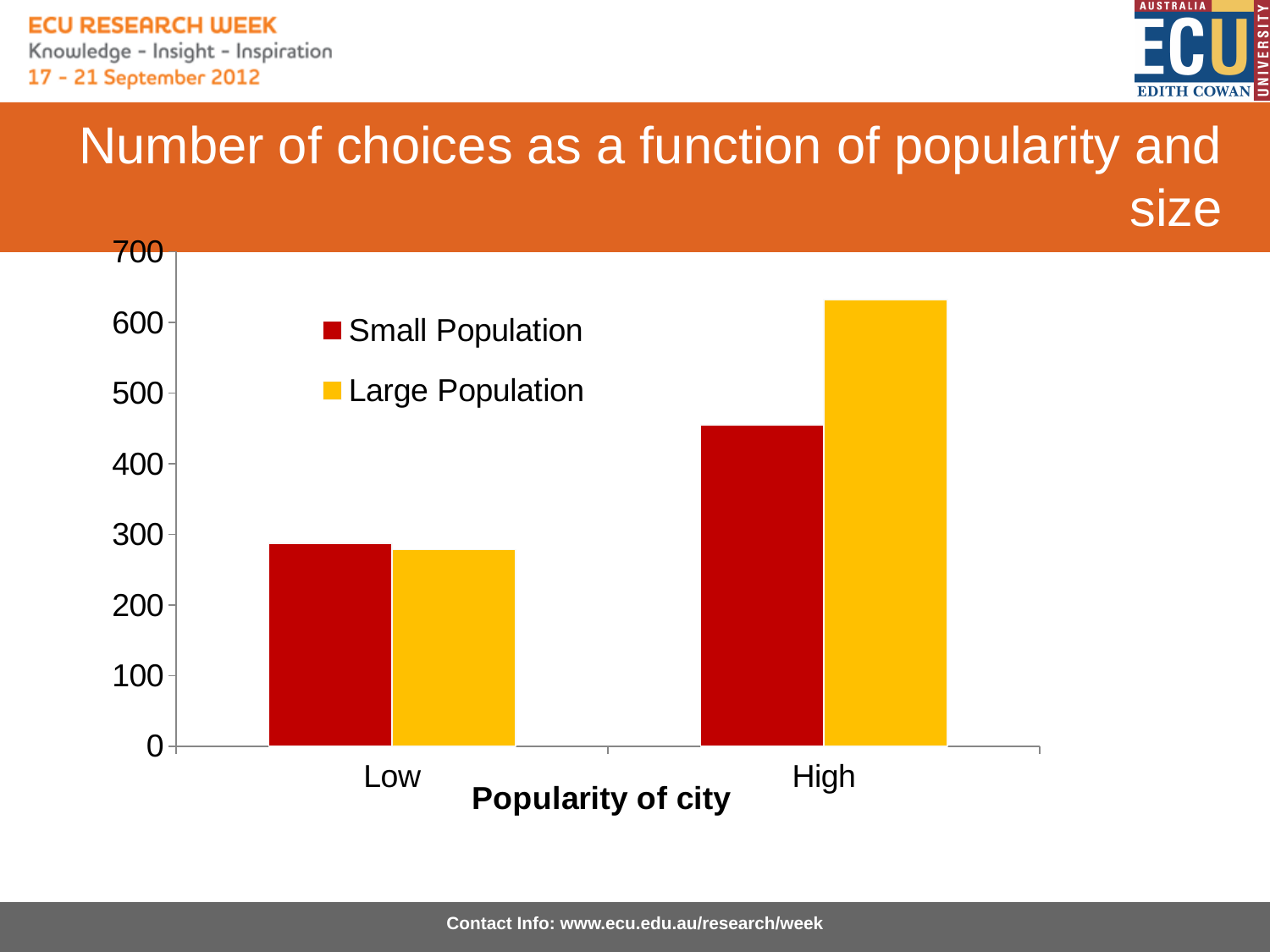
What kind of chart is shown on the slide? bar chart What is the title of the x axis? Popularity of city Is the value for Small Population at High popularity greater or less than 400? greater For the High popularity category, which is larger: Small Population or Large Population? Large Population For the Small Population series, which category has the larger value: Low or High? High Is the value for Large Population at Low popularity greater or less than 300? less Is the value for Large Population at High popularity greater or less than 600? greater Which series has the tallest bar on the chart? Large Population How many series does the legend list? 2 How many categories are shown on the x axis? 2 Do the values for the Large Population series rise or fall from Low to High popularity? rise